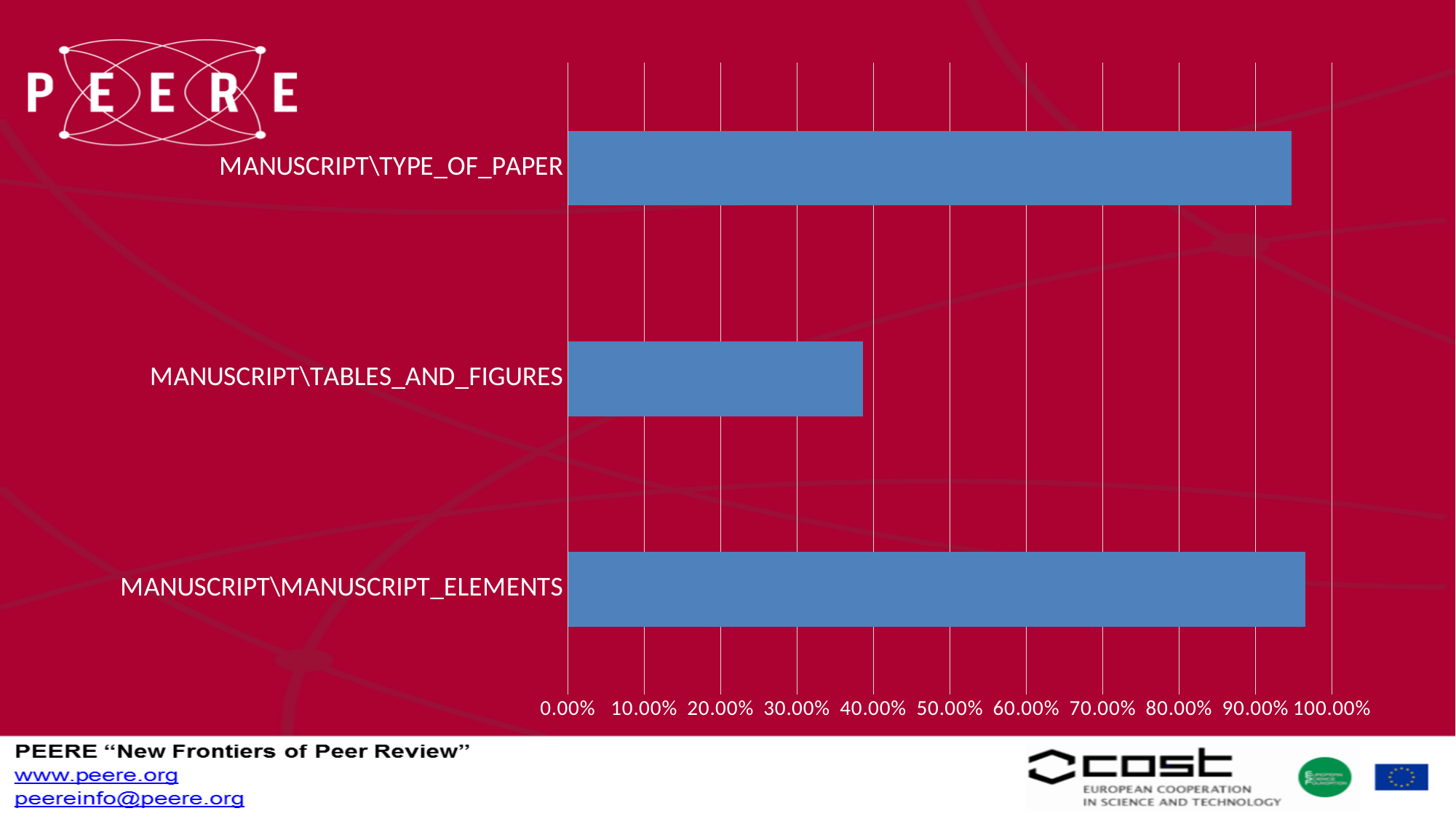
What kind of chart is shown on the slide? bar chart Is the value for MANUSCRIPT\TABLES_AND_FIGURES greater or less than 30.00%? greater What colour are the bars in the chart? blue Is the value for MANUSCRIPT\MANUSCRIPT_ELEMENTS greater or less than 100.00%? less Is the value for MANUSCRIPT\MANUSCRIPT_ELEMENTS greater or less than 90.00%? greater How many categories are plotted in the chart? 3 What is the highest value shown on the chart's horizontal axis? 100.00% Which is larger, the value for MANUSCRIPT\MANUSCRIPT_ELEMENTS or the value for MANUSCRIPT\TABLES_AND_FIGURES? MANUSCRIPT\MANUSCRIPT_ELEMENTS Which category has the lowest value in the chart? MANUSCRIPT\TABLES_AND_FIGURES Which is larger, the value for MANUSCRIPT\TYPE_OF_PAPER or the value for MANUSCRIPT\TABLES_AND_FIGURES? MANUSCRIPT\TYPE_OF_PAPER